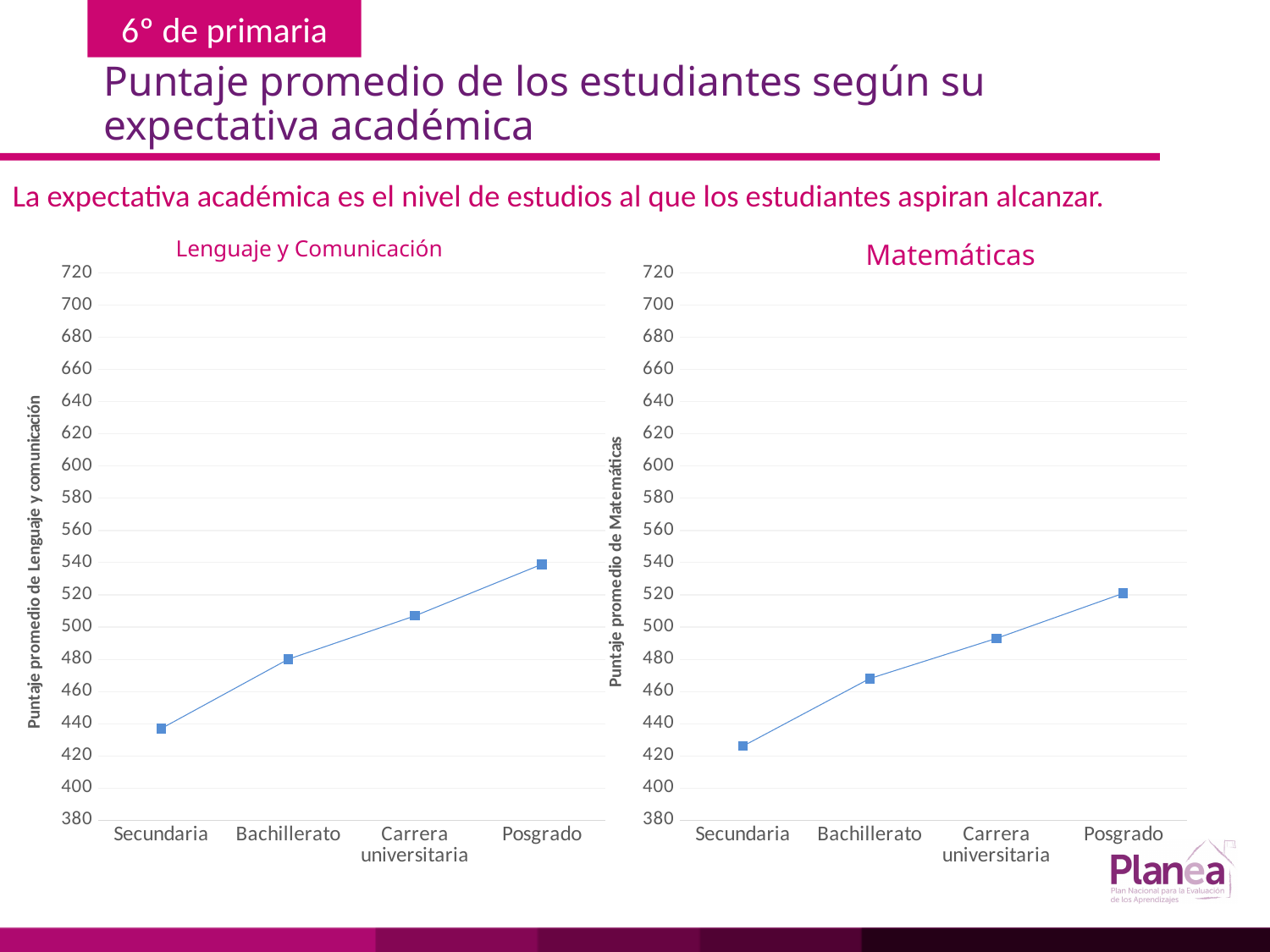
What kind of chart is the Lenguaje y Comunicación chart? Line chart In the Lenguaje y Comunicación chart, which is larger, the value for Bachillerato or the value for Carrera universitaria? Carrera universitaria What is the y-axis label of the Matemáticas chart? Puntaje promedio de Matemáticas In the Lenguaje y Comunicación chart, is the value for Posgrado greater or less than 520? greater How many categories are shown on the x axis of the Matemáticas chart? 4 In the Lenguaje y Comunicación chart, which category has the highest average score? Posgrado In the Matemáticas chart, do the values rise or fall from Secundaria to Posgrado? Rise In the Matemáticas chart, is the value for Carrera universitaria greater or less than 480? greater In the Matemáticas chart, which category has the lowest average score? Secundaria In the Matemáticas chart, is the value for Secundaria greater or less than 440? less In the Matemáticas chart, which category has the highest average score? Posgrado In the Lenguaje y Comunicación chart, which category has the lowest average score? Secundaria